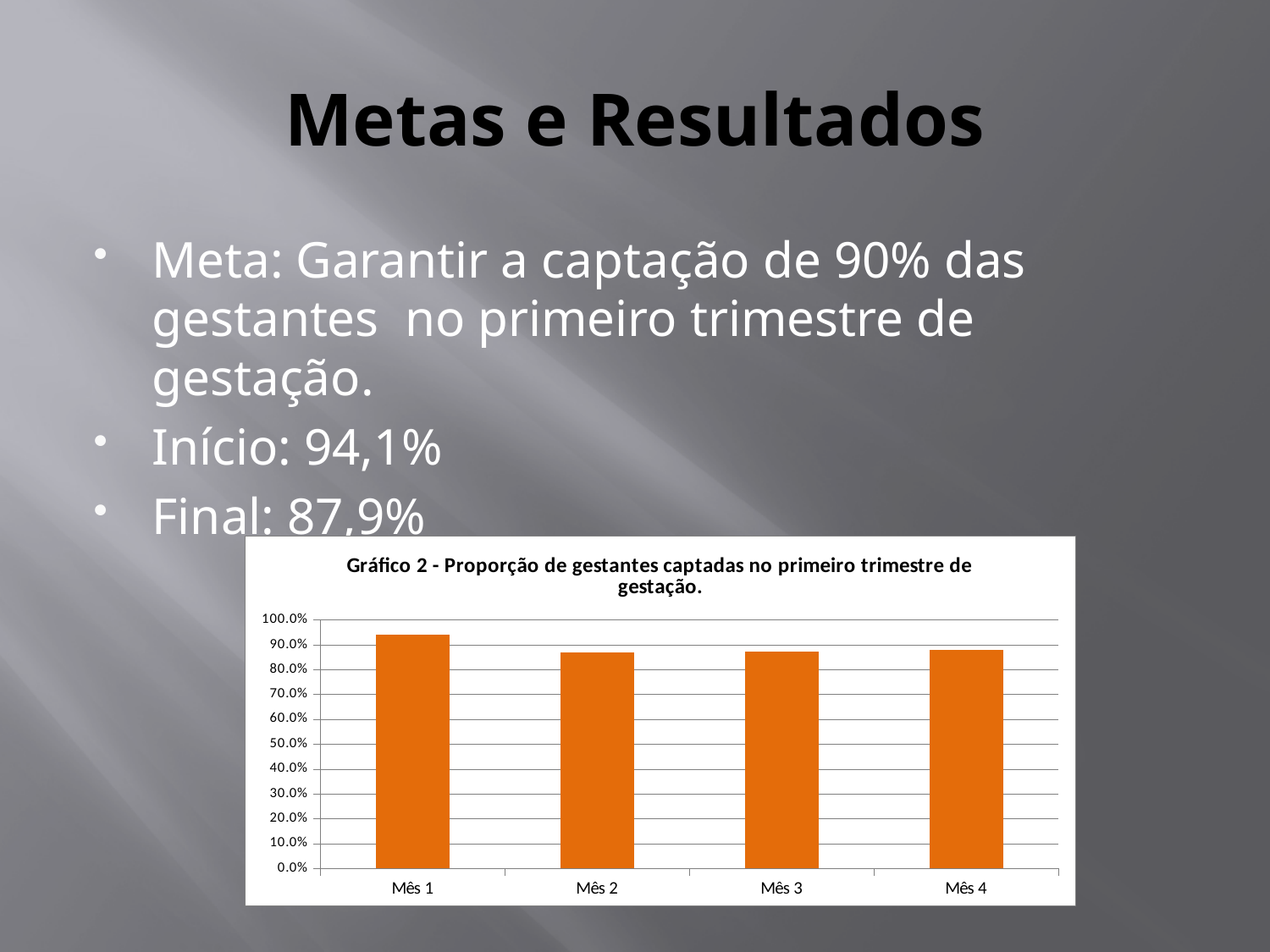
What is the label of the first category on the x axis? Mês 1 Which month has the highest value in the chart? Mês 1 Is the value for Mês 4 greater or less than 90.0%? less What kind of chart is shown on the slide? bar chart What is the title of the chart? Gráfico 2 - Proporção de gestantes captadas no primeiro trimestre de gestação. How many months (categories) are plotted in the chart? 4 Is the value for Mês 1 greater or less than 90.0%? greater Is the value for Mês 3 greater or less than 80.0%? greater Which is larger, the value for Mês 1 or the value for Mês 2? Mês 1 Which is larger, the value for Mês 1 or the value for Mês 4? Mês 1 Does the value rise or fall from Mês 1 to Mês 2? fall